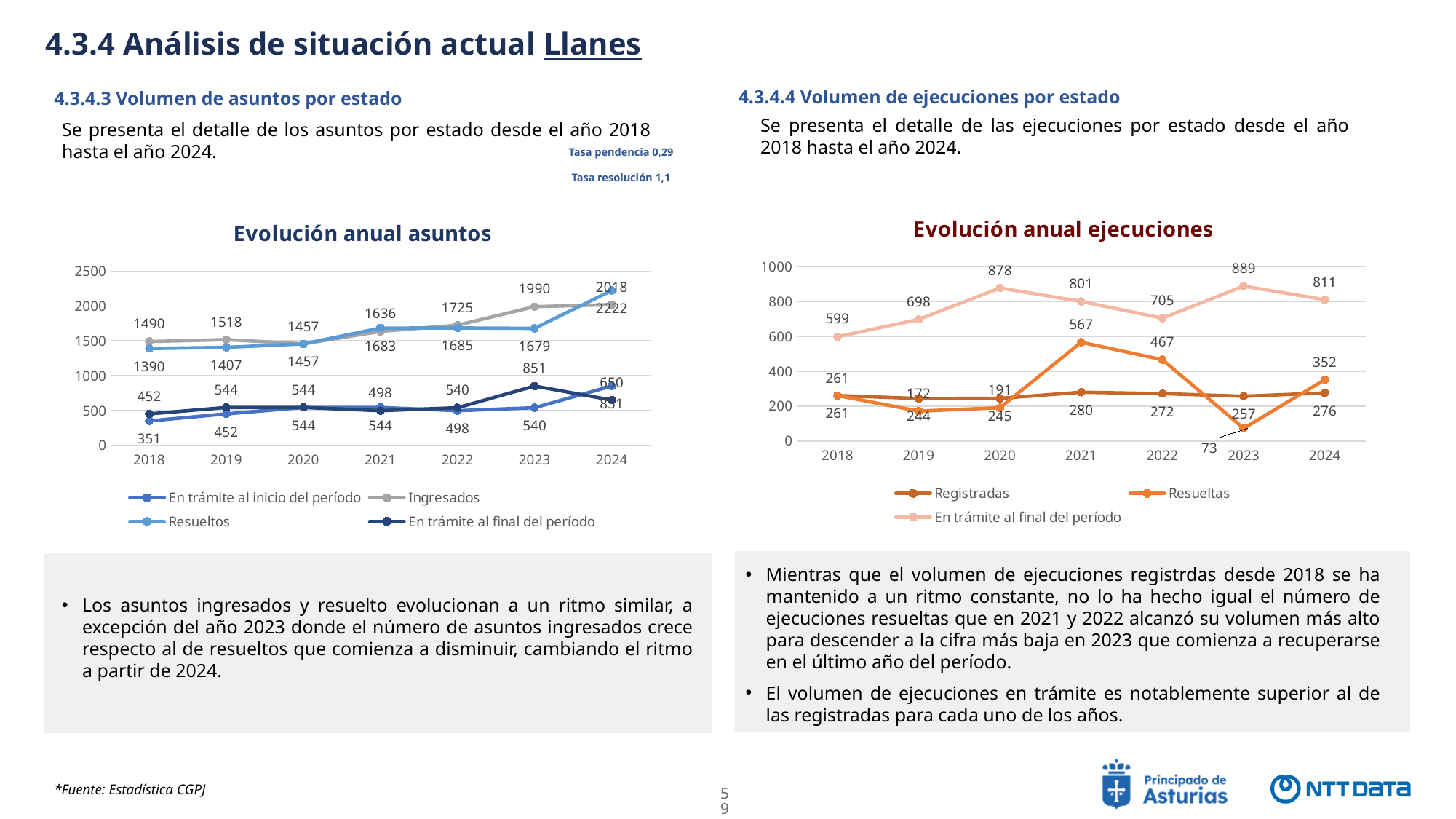
In the 'Evolución anual asuntos' chart, how many years are shown on the x axis? 7 In the 'Evolución anual asuntos' chart, what is the value of 'Ingresados' in 2023? 1990 In the 'Evolución anual ejecuciones' chart, in which year is 'Resueltas' lowest? 2023 In the 'Evolución anual ejecuciones' chart, how many series does the legend list? 3 In the 'Evolución anual ejecuciones' chart, is the value of 'Resueltas' in 2021 greater or less than 400? greater In the 'Evolución anual asuntos' chart, what is the value of 'Resueltos' in 2024? 2222 In the 'Evolución anual ejecuciones' chart, what is the value of 'En trámite al final del período' in 2020? 878 In the 'Evolución anual asuntos' chart, how many series does the legend list? 4 In the 'Evolución anual ejecuciones' chart, in which year is 'En trámite al final del período' highest? 2023 In the 'Evolución anual ejecuciones' chart, what is the difference between 'Resueltas' in 2021 and in 2022? 100 In the 'Evolución anual asuntos' chart, does the 'Ingresados' series generally rise or fall from 2018 to 2024? Rise What kind of chart is 'Evolución anual asuntos'? Line chart